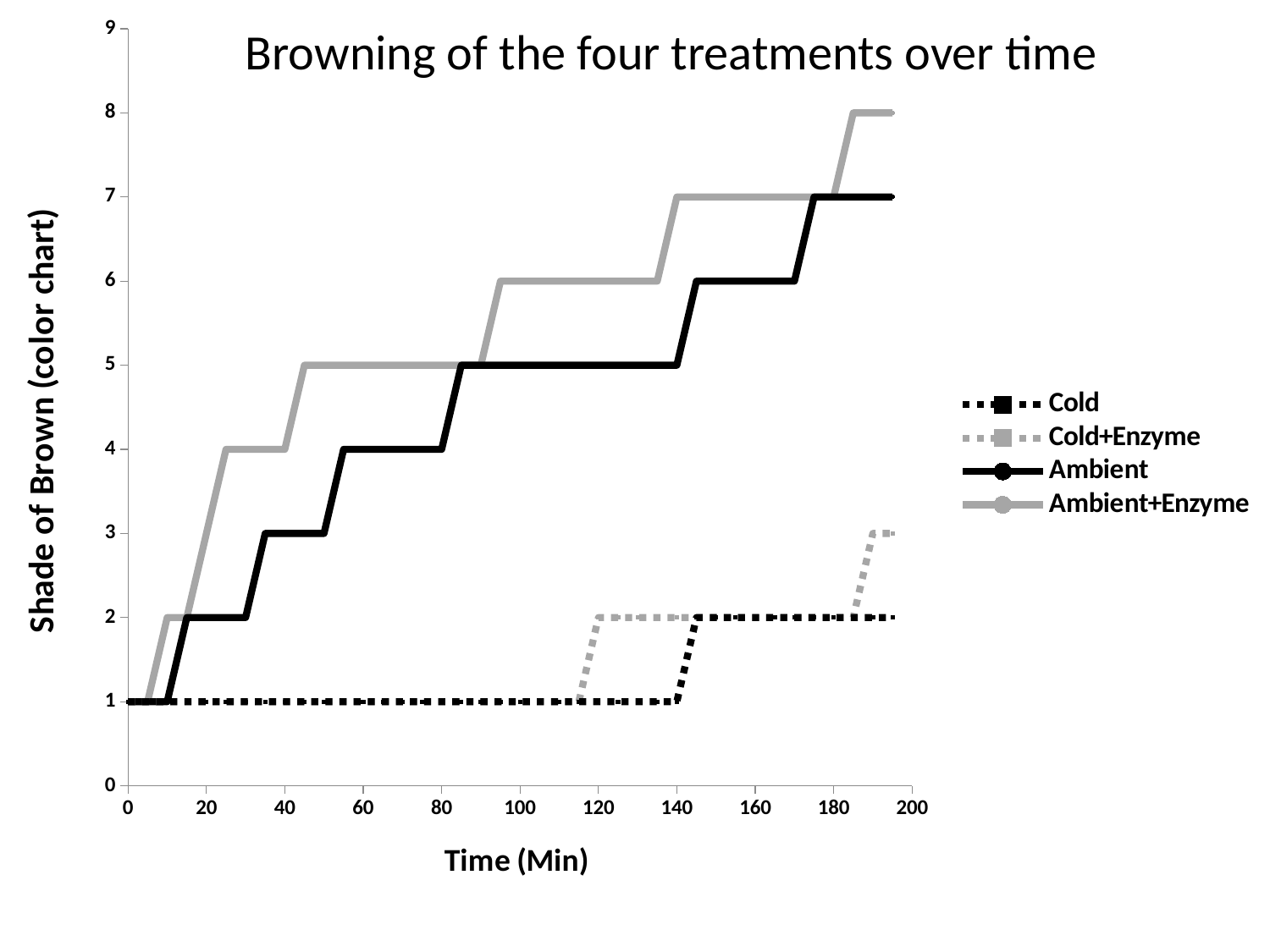
Which series has the lowest shade of brown at the end of the time period? Cold What shade of brown does the Ambient+Enzyme series reach at the end of the time period? 8 How many series does the legend list? 4 Do the values for the Ambient series rise or fall as time increases? rise What kind of chart is shown on the slide? line chart What is the difference between the final shade of brown for Ambient+Enzyme and for Cold? 6 Which series has a higher shade of brown at 100 minutes, Ambient or Ambient+Enzyme? Ambient+Enzyme Which series reaches the highest shade of brown by the end of the time period? Ambient+Enzyme What is the label of the x axis? Time (Min) What is the title of the chart? Browning of the four treatments over time What shade of brown does the Cold+Enzyme series reach at the end of the time period? 3 What shade of brown does the Ambient series reach at the end of the time period? 7